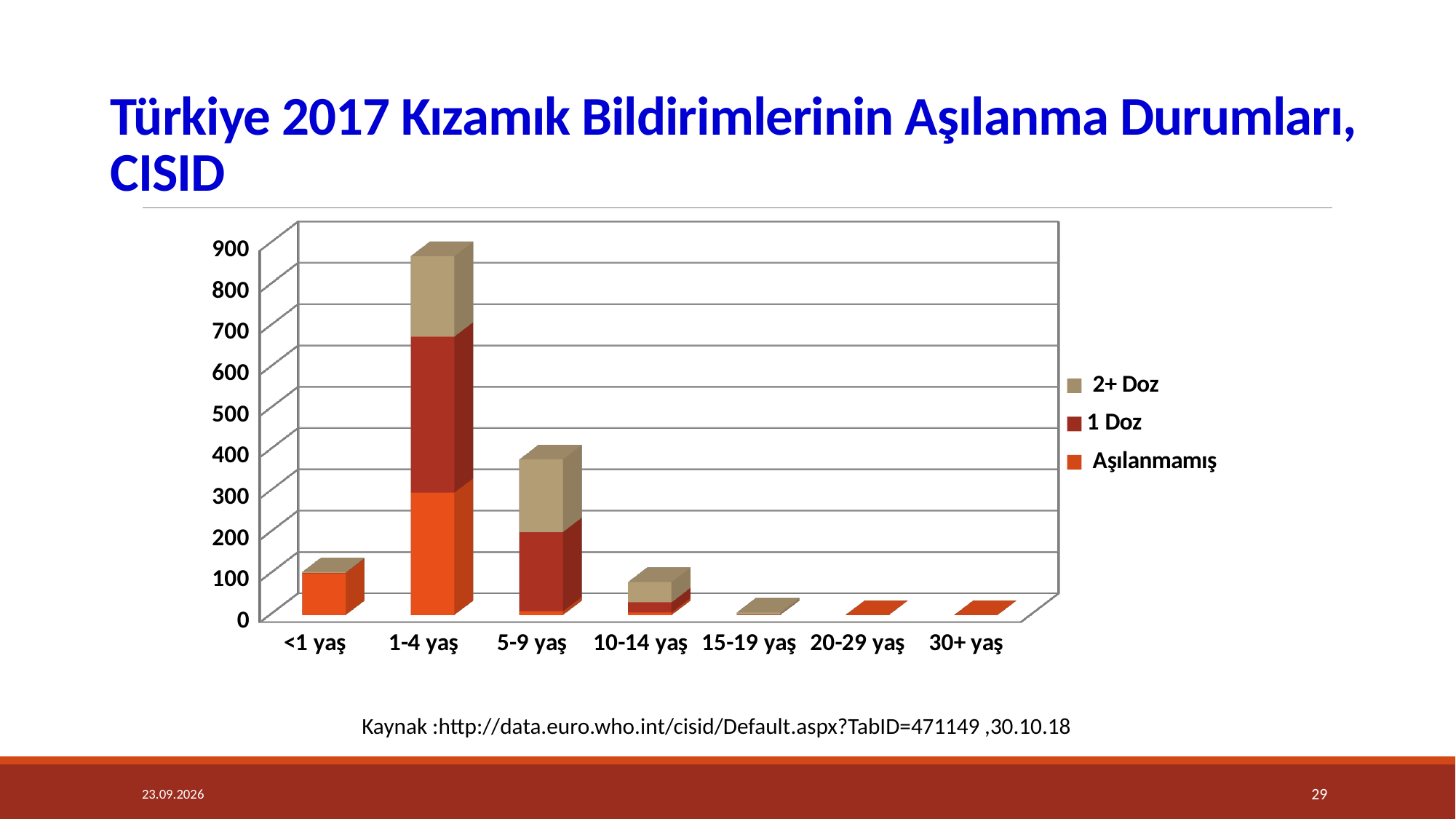
Is the total stacked bar for 1-4 yaş greater or less than 800? greater How many series does the legend list? 3 What kind of chart is shown on the slide? Stacked bar chart Which stacked bar is taller, 5-9 yaş or 10-14 yaş? 5-9 yaş Which stacked bar is taller, 1-4 yaş or 5-9 yaş? 1-4 yaş How many age categories are shown on the x axis? 7 From 1-4 yaş onward, do the stacked bar totals rise or fall as age increases? fall Is the total stacked bar for 10-14 yaş greater or less than 200? less Is the total stacked bar for 5-9 yaş greater or less than 300? greater Which age group has the tallest stacked bar? 1-4 yaş Which series is shown in orange in the legend? Aşılanmamış